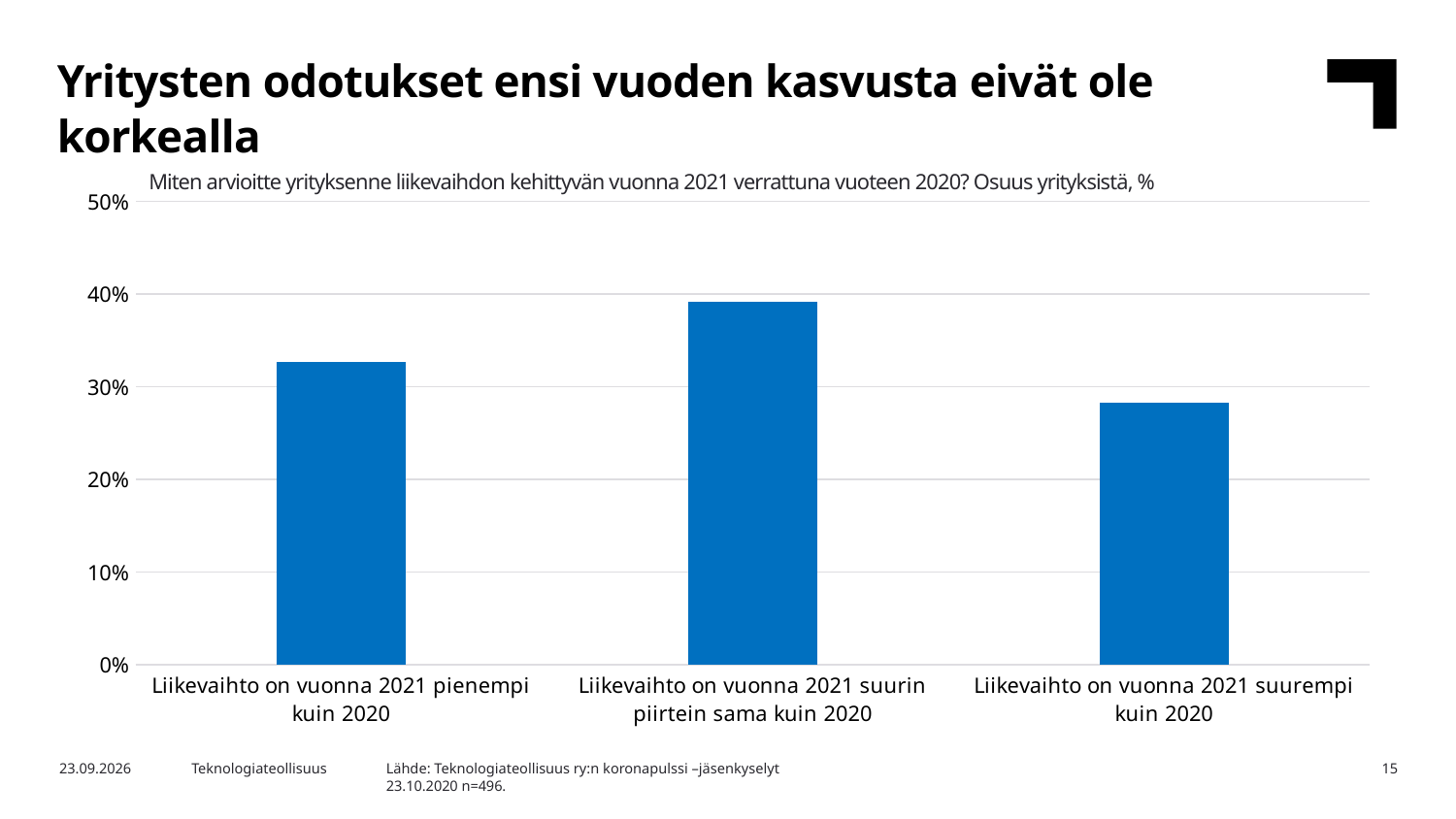
Which is larger: the value for "Liikevaihto on vuonna 2021 pienempi kuin 2020" or the value for "Liikevaihto on vuonna 2021 suurempi kuin 2020"? Liikevaihto on vuonna 2021 pienempi kuin 2020 Is the value for "Liikevaihto on vuonna 2021 pienempi kuin 2020" greater or less than 30%? greater Is the value for "Liikevaihto on vuonna 2021 suurempi kuin 2020" greater or less than 20%? greater Is the value for "Liikevaihto on vuonna 2021 suurempi kuin 2020" greater or less than 30%? less Which category has the lowest bar? Liikevaihto on vuonna 2021 suurempi kuin 2020 Which category has the highest bar? Liikevaihto on vuonna 2021 suurin piirtein sama kuin 2020 How many categories are shown on the x axis of the chart? 3 What colour are the bars in the chart? blue What is the highest value shown on the y axis of the chart? 50% What kind of chart is shown on the slide? bar chart Which is larger: the value for "Liikevaihto on vuonna 2021 suurin piirtein sama kuin 2020" or the value for "Liikevaihto on vuonna 2021 pienempi kuin 2020"? Liikevaihto on vuonna 2021 suurin piirtein sama kuin 2020